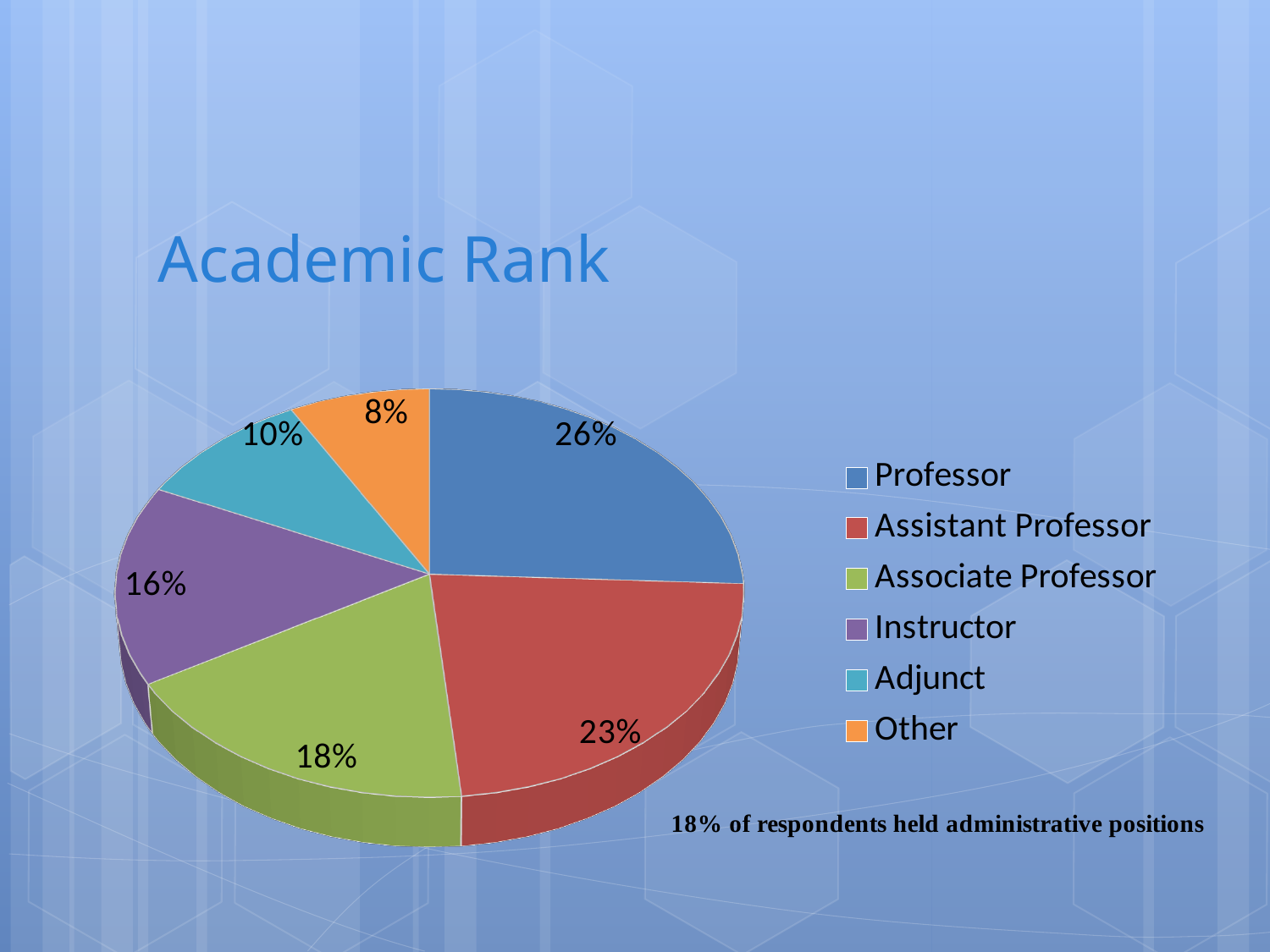
Which is larger, the share for Adjunct or the share for Associate Professor? Associate Professor What type of chart is shown on the slide? pie chart Which academic rank has the largest slice of the pie? Professor What share of the pie does Assistant Professor hold? 23% What share of the pie does Adjunct hold? 10% What share of the pie does Instructor hold? 16% Which academic rank has the smallest slice of the pie? Other How many categories does the pie chart show? 6 What colour is the Other slice in the pie chart? orange What is the difference in percentage points between Professor and Instructor? 10